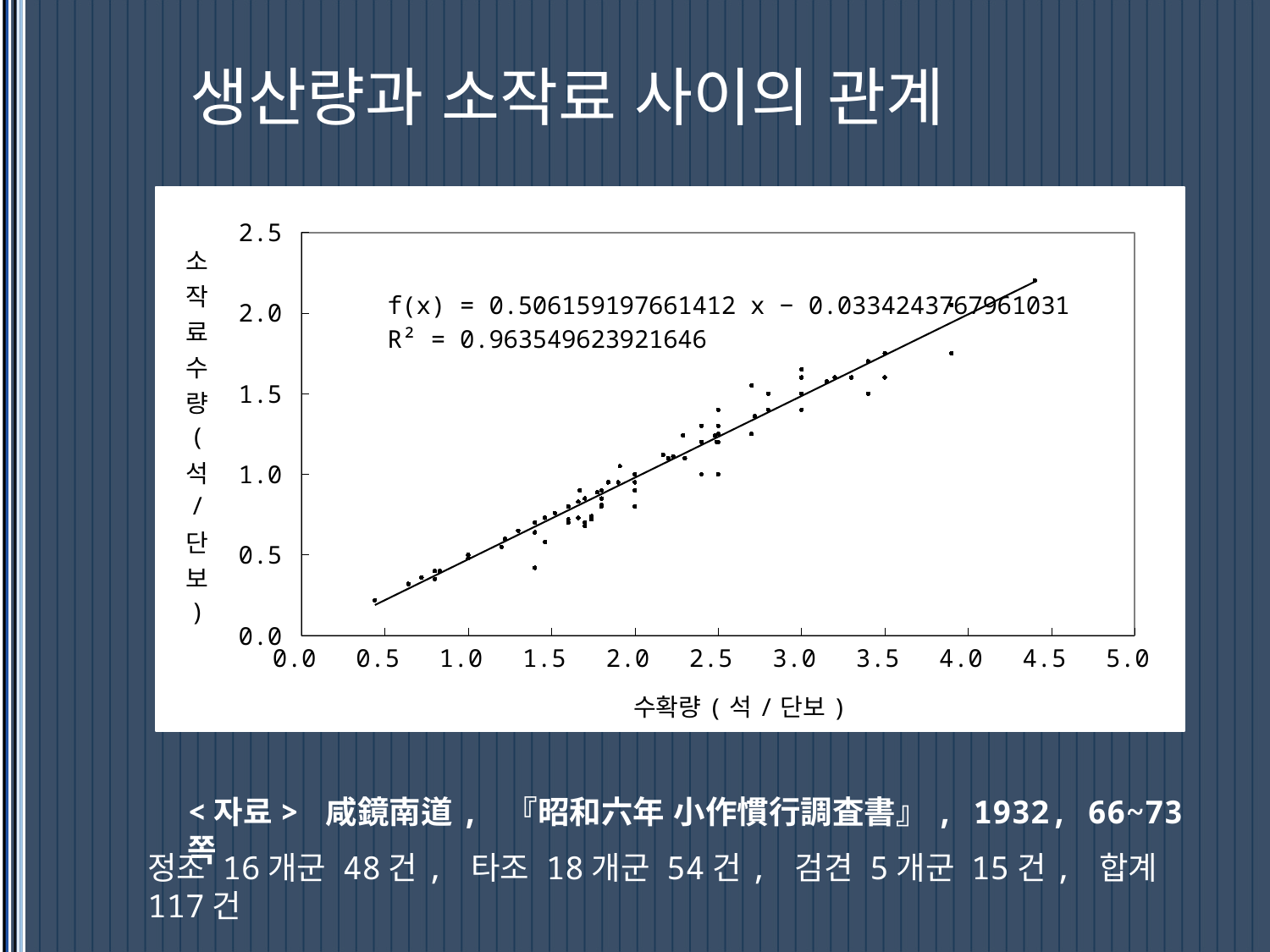
What is the title of the chart? 생산량과 소작료 사이의 관계 What is the label of the x axis? 수확량 ( 석 / 단보 ) What is the slope of the fitted trendline equation shown on the chart? 0.506159197661412 According to the slide, how many cases (건) in total are plotted? 117 건 What is the highest value shown on the y axis? 2.5 Do the plotted values rise or fall as 수확량 increases along the x axis? rise Is the 소작료수량 value for the point near 수확량 0.5 greater or less than 0.5? less What R² value is printed on the chart? 0.963549623921646 Is the 소작료수량 value for the point near 수확량 3.9 greater or less than 1.5? greater Is the 소작료수량 value for the point near 수확량 4.4 greater or less than 2.0? greater What kind of chart is shown on the slide? scatter plot What is the intercept of the fitted trendline equation shown on the chart? −0.0334243767961031